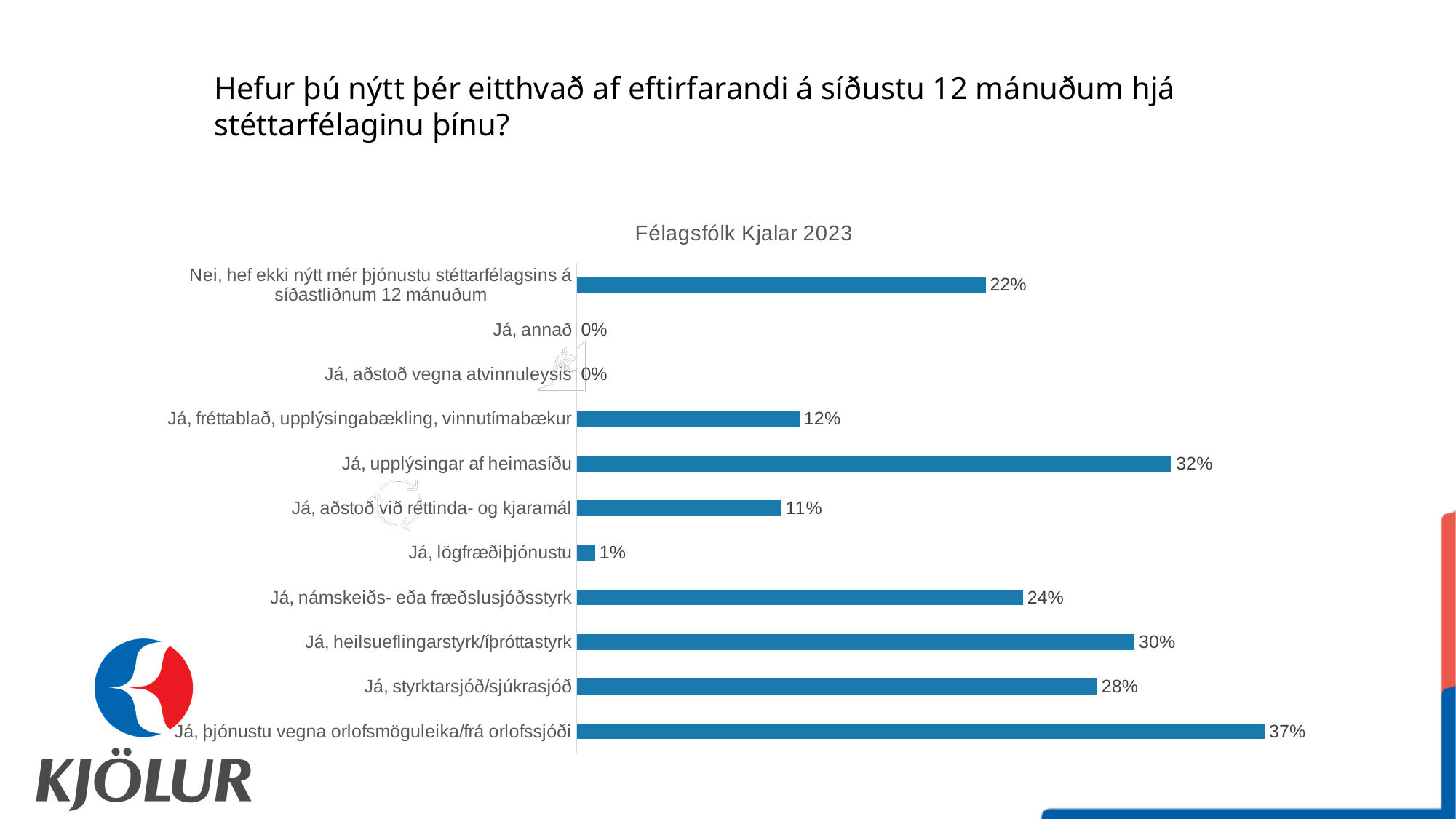
What is the value for "Já, þjónustu vegna orlofsmöguleika/frá orlofssjóði"? 37% What is the value for "Nei, hef ekki nýtt mér þjónustu stéttarfélagsins á síðastliðnum 12 mánuðum"? 22% Which category has the highest value? Já, þjónustu vegna orlofsmöguleika/frá orlofssjóði What is the value for "Já, heilsueflingarstyrk/íþróttastyrk"? 30% What is the difference between "Já, heilsueflingarstyrk/íþróttastyrk" and "Já, styrktarsjóð/sjúkrasjóð"? 2% What is the title of the chart? Félagsfólk Kjalar 2023 What is the difference between "Já, upplýsingar af heimasíðu" and "Já, fréttablað, upplýsingabækling, vinnutímabækur"? 20% How many categories have a value of 0%? 2 How many categories are shown in the chart? 11 What is the value for "Já, lögfræðiþjónustu"? 1% What kind of chart is shown? Bar chart Which is larger: "Já, styrktarsjóð/sjúkrasjóð" or "Já, námskeiðs- eða fræðslusjóðsstyrk"? Já, styrktarsjóð/sjúkrasjóð